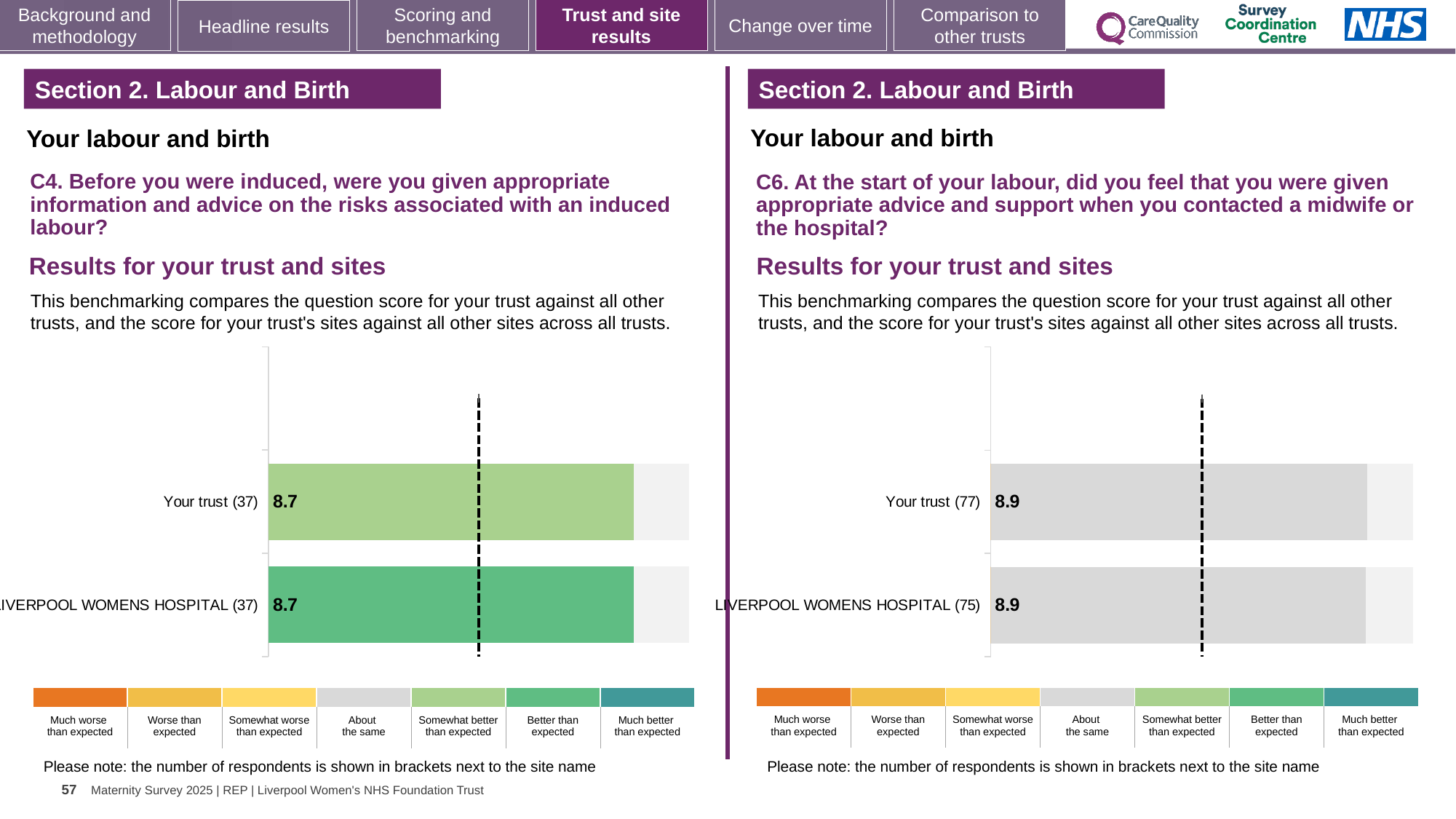
How many bars are plotted in the right chart (C6)? 2 In the left chart (C4), what is the score for Your trust? 8.7 In the right chart (C6), what is the score for LIVERPOOL WOMENS HOSPITAL? 8.9 In the right chart (C6), which benchmark category does the grey colour of the bars correspond to in the legend? About the same In the left chart (C4), what is the score for LIVERPOOL WOMENS HOSPITAL? 8.7 In the right chart (C6), what is the difference between the score for Your trust and the score for LIVERPOOL WOMENS HOSPITAL? 0 In the right chart (C6), what is the score for Your trust? 8.9 How many bars are plotted in the left chart (C4)? 2 In the right chart (C6), how many respondents are shown in brackets for LIVERPOOL WOMENS HOSPITAL? 75 In the left chart (C4), what is the difference between the score for Your trust and the score for LIVERPOOL WOMENS HOSPITAL? 0 What kind of chart is used for the C6 results on the right? Bar chart In the left chart (C4), how many respondents are shown in brackets for Your trust? 37